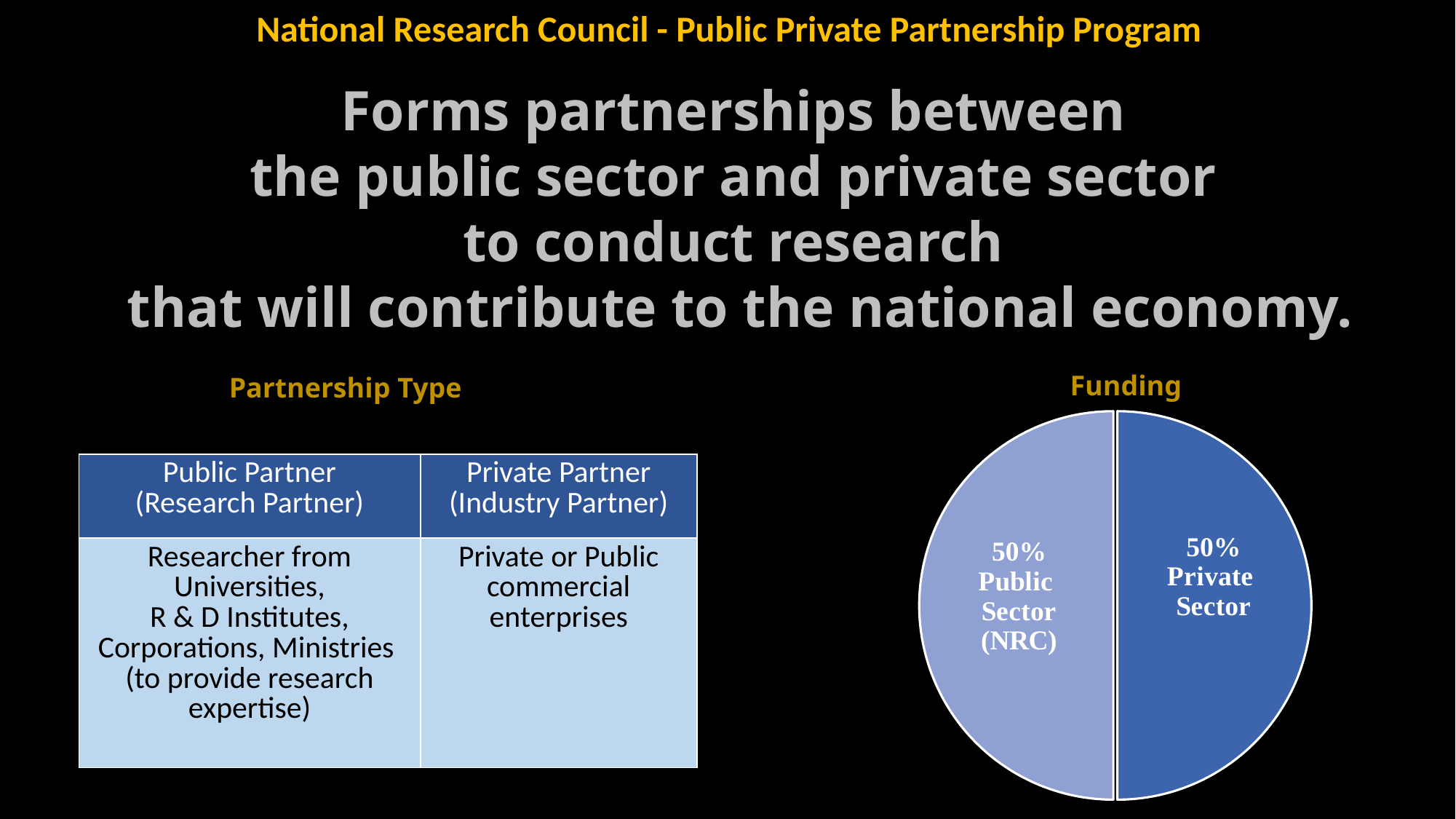
In the Funding pie chart, what is the difference between the Public Sector (NRC) share and the Private Sector share? 0% In the Funding pie chart, do the Public Sector (NRC) and Private Sector slices have the same share? Yes What is the title of the pie chart on the slide? Funding In the Funding pie chart, what do the two slices add up to? 100% In the Funding pie chart, what share of funding comes from the Public Sector (NRC)? 50% In the Funding pie chart, which slice is shown in the darker blue colour? Private Sector In the Funding pie chart, what share of funding comes from the Private Sector? 50% How many slices does the Funding pie chart have? 2 What kind of chart is shown under the heading "Funding"? pie chart